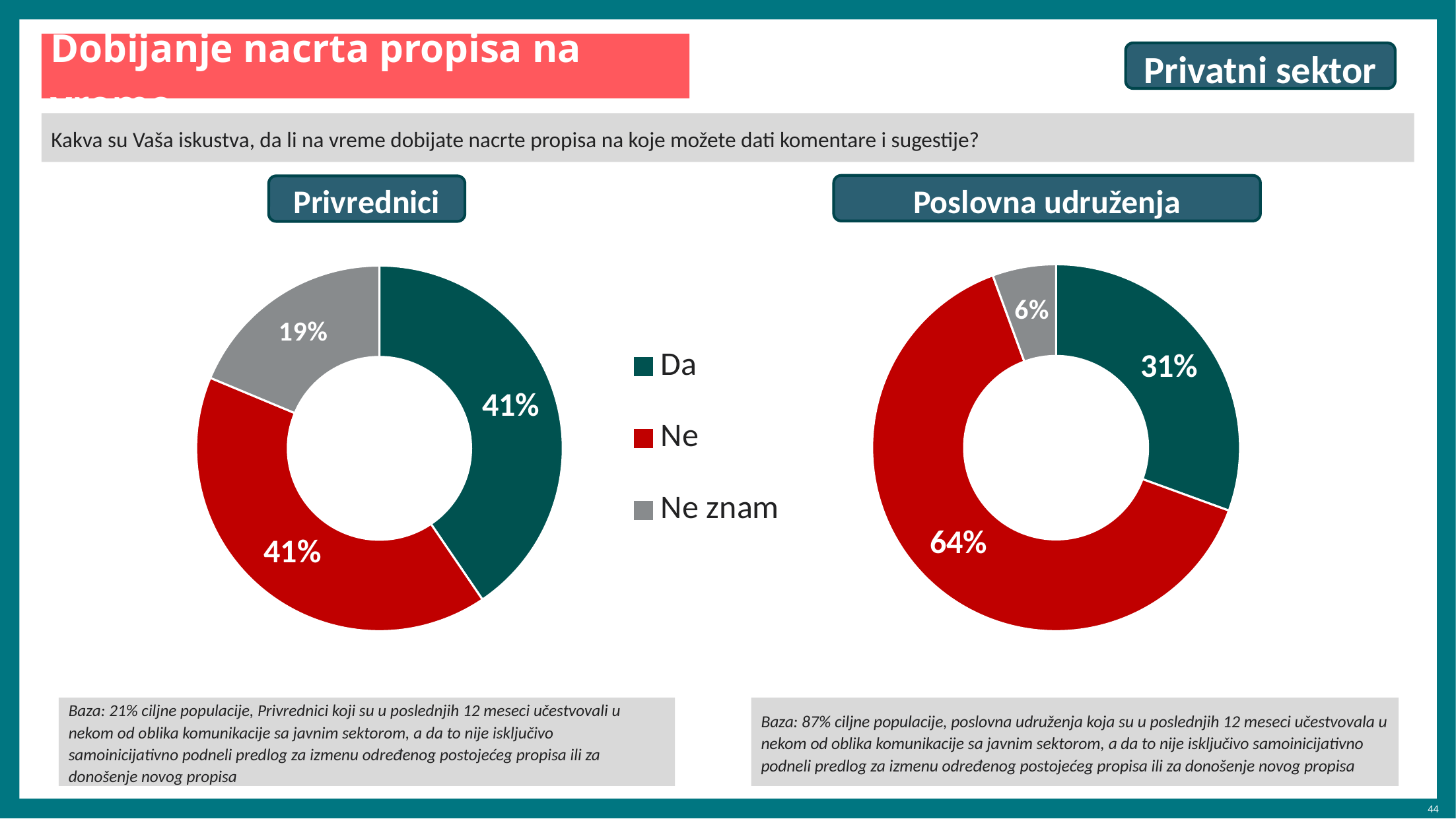
In the Privrednici chart, what share answered Ne znam? 19% Is the Da share larger in the Privrednici chart or in the Poslovna udruženja chart? Privrednici In the Privrednici chart, which answer has the smallest share? Ne znam In the Privrednici chart, what share answered Da? 41% In the Poslovna udruženja chart, which answer has the largest share? Ne In the Poslovna udruženja chart, what share answered Da? 31% In the Poslovna udruženja chart, what share answered Ne? 64% In the Poslovna udruženja chart, which answer has the smallest share? Ne znam In the Poslovna udruženja chart, what is the difference between the Ne and Da shares? 33 percentage points How many entries does the legend list? 3 In the Poslovna udruženja chart, what share answered Ne znam? 6% What type of chart is used on this slide? Doughnut (pie) chart